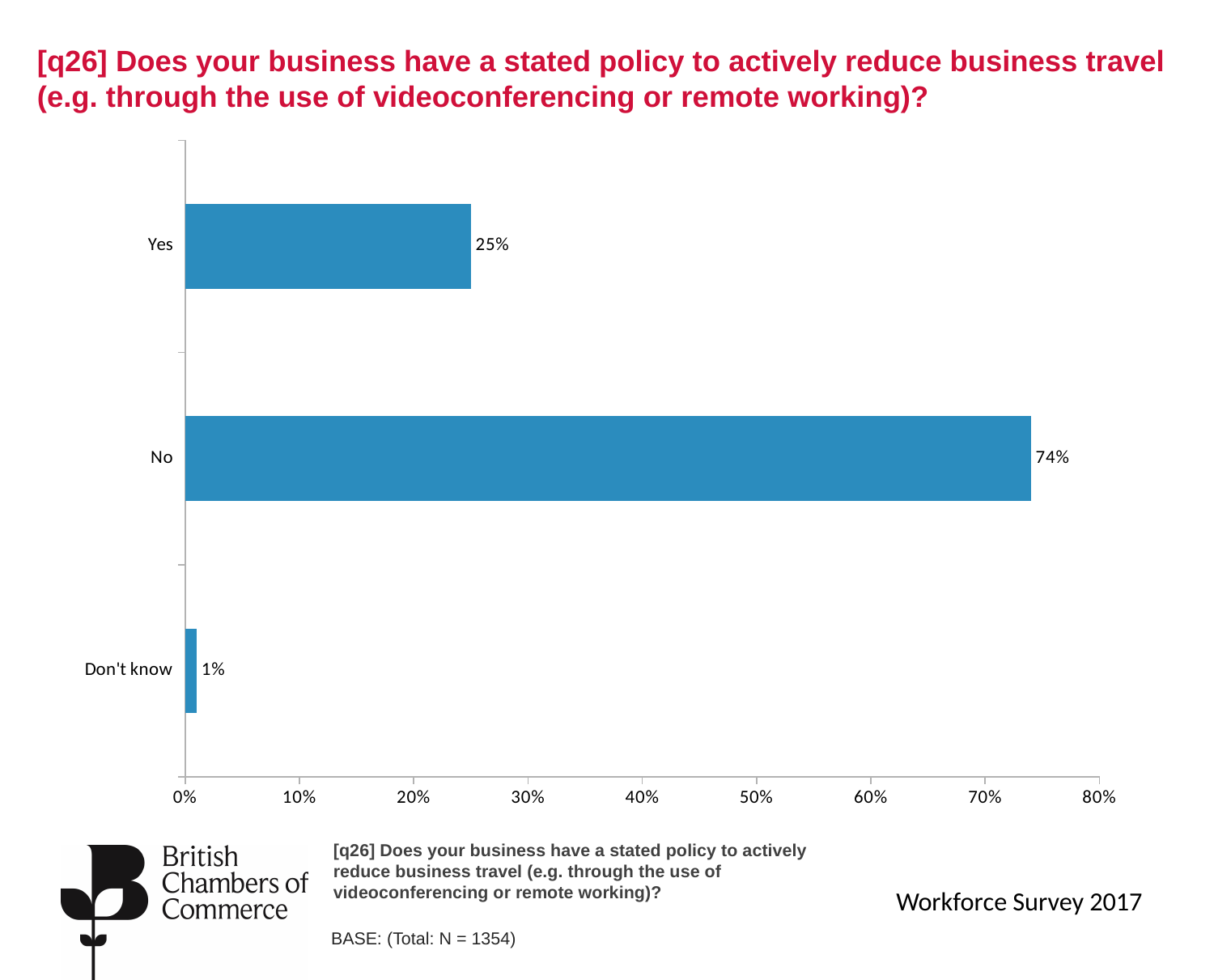
What percentage of businesses answered "Yes" to having a stated policy to actively reduce business travel? 25% What percentage of businesses answered "No"? 74% What is the base (total N) for the survey question shown? N = 1354 Which response category has the lowest value? Don't know Is the value for "No" greater or less than 70%? greater Which is larger, the value for "Yes" or the value for "Don't know"? Yes What is the difference in percentage points between the "No" and "Yes" responses? 49 percentage points Which response category has the highest value? No What percentage of businesses answered "Don't know"? 1% What type of chart is shown on the slide? Bar chart Is the value for "Yes" greater or less than 30%? less How many response categories are shown in the chart? 3